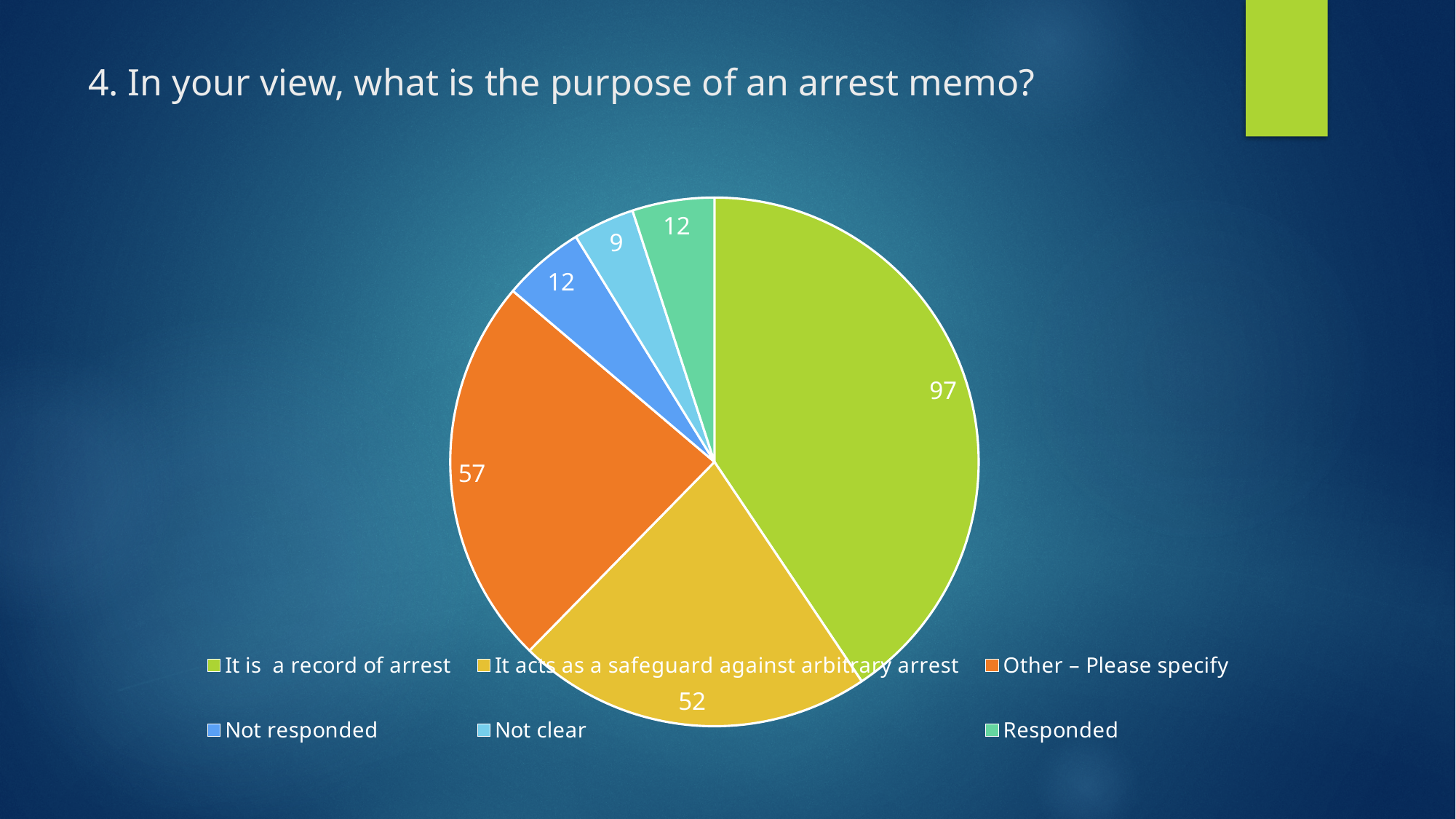
What is the value for "It is a record of arrest"? 97 What is the value for "Not clear"? 9 What kind of chart is shown on the slide? pie chart Which is larger, the value for "Other – Please specify" or the value for "It acts as a safeguard against arbitrary arrest"? Other – Please specify Which category has the smallest slice of the pie? Not clear What is the value for "It acts as a safeguard against arbitrary arrest"? 52 What colour is the slice for "Not responded"? blue What is the difference between the values for "It is a record of arrest" and "Other – Please specify"? 40 What is the value for "Other – Please specify"? 57 What is the total of all the slices in the pie? 239 Which category has the largest slice of the pie? It is a record of arrest How many categories does the legend list? 6